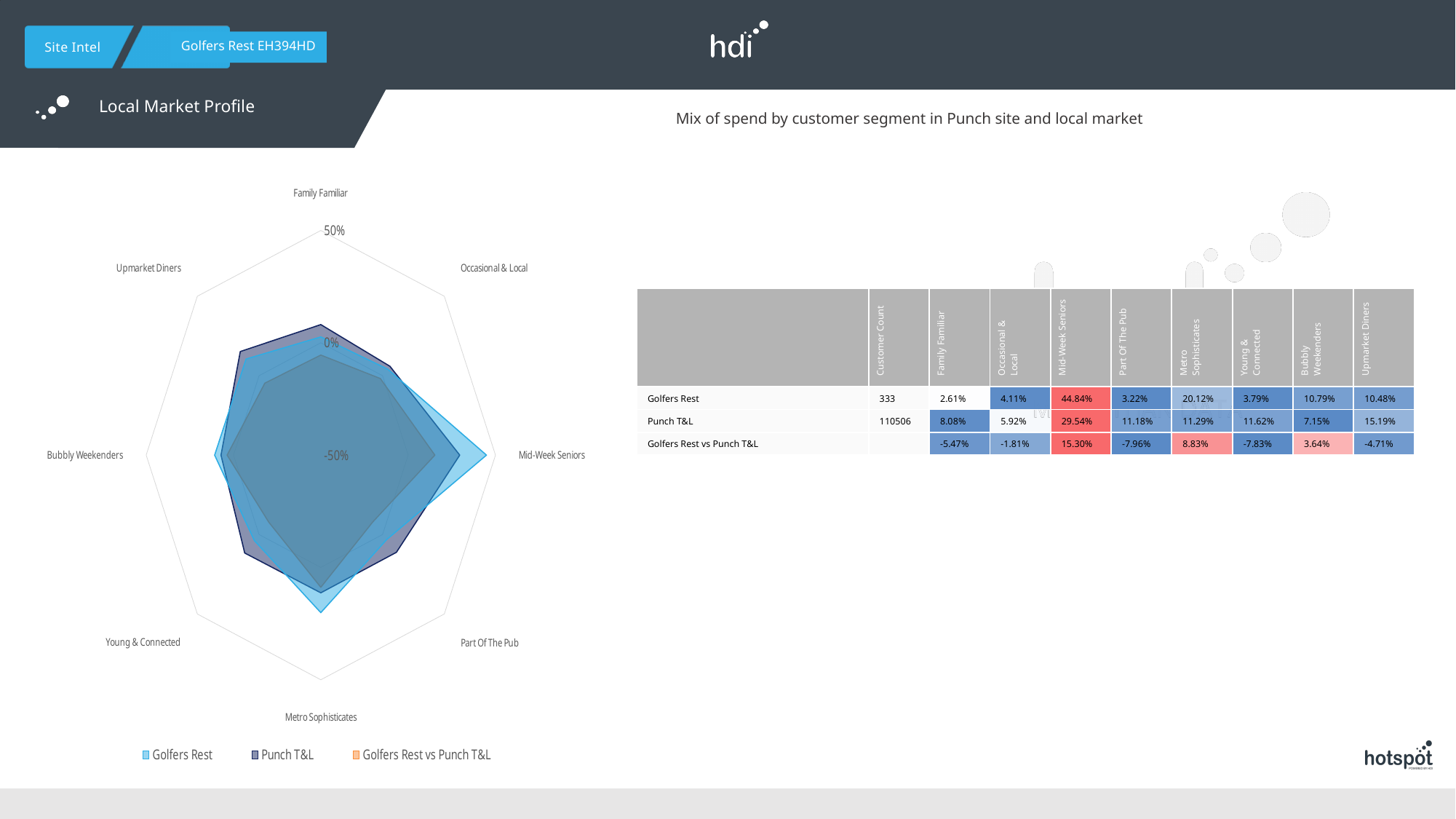
What is the Golfers Rest value for Mid-Week Seniors? 44.84% For Metro Sophisticates, which is larger: Golfers Rest or Punch T&L? Golfers Rest What is the Golfers Rest value for Metro Sophisticates? 20.12% What is the title shown above the table on the slide? Mix of spend by customer segment in Punch site and local market What is the Punch T&L value for Upmarket Diners? 15.19% How many series does the radar chart's legend list? 3 What is the difference between the Golfers Rest and Punch T&L values for Mid-Week Seniors? 15.30% What kind of chart is shown on the left of the slide? radar chart How many customer segment categories does the radar chart have? 8 Which segment has the lowest value for Punch T&L? Occasional & Local Which segment has the highest value for Golfers Rest? Mid-Week Seniors Which segment has the lowest value for Golfers Rest? Family Familiar